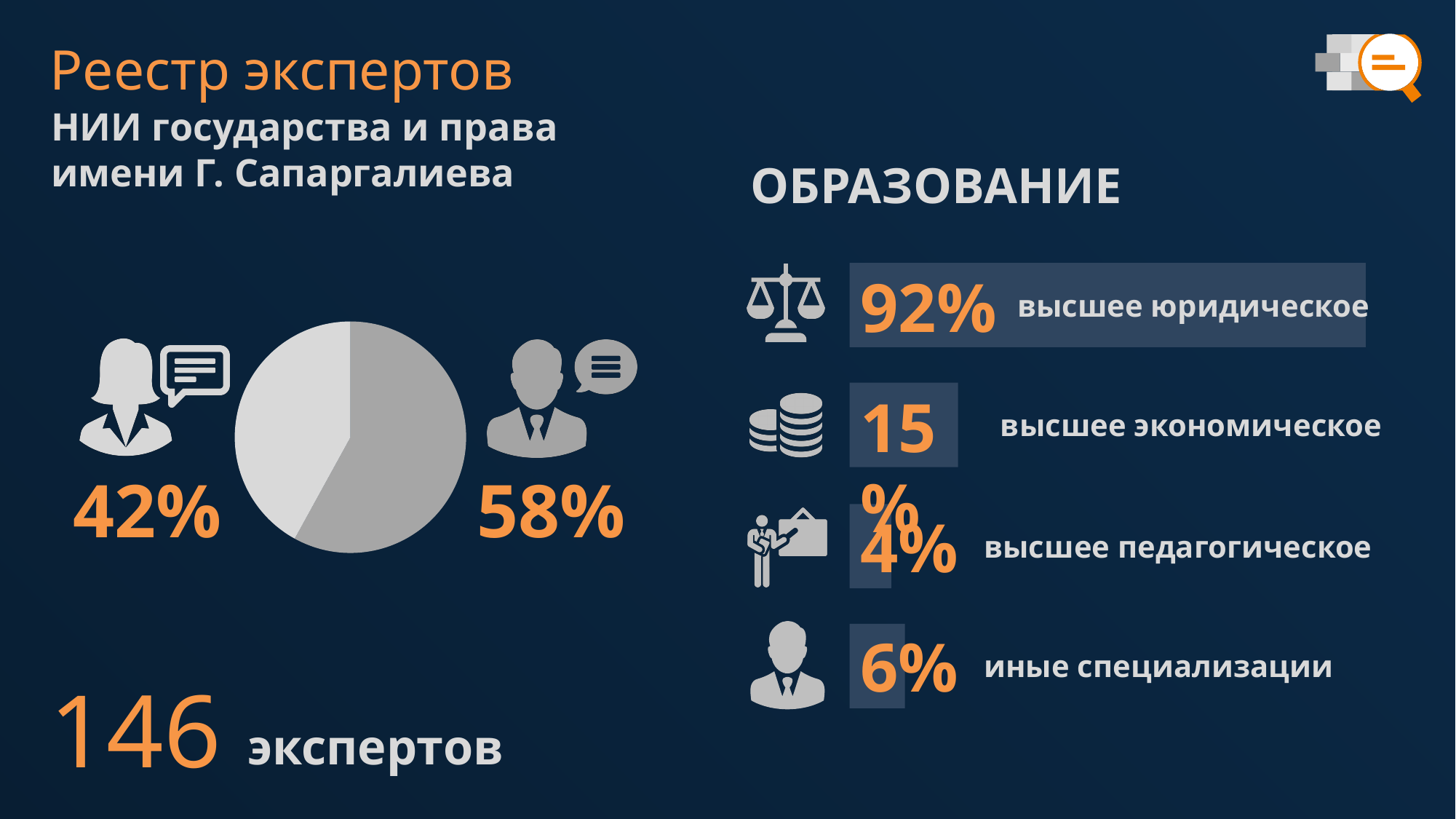
By how many percentage points does the larger pie slice exceed the smaller one? 16 How many slices does the pie chart have? 2 What share of the pie chart is labelled next to the male icon? 58% Is the share labelled next to the female icon greater or less than 50%? less What kind of chart is shown on the left of the slide? pie chart Is the share labelled next to the male icon greater or less than 50%? greater Which slice of the pie chart is larger, the one labelled 42% or the one labelled 58%? 58% What is the smallest share shown on the pie chart? 42% What is the total number of experts stated below the pie chart? 146 What colour are the percentage labels of the pie chart? orange What is the largest share shown on the pie chart? 58% What share of the pie chart is labelled next to the female icon? 42%